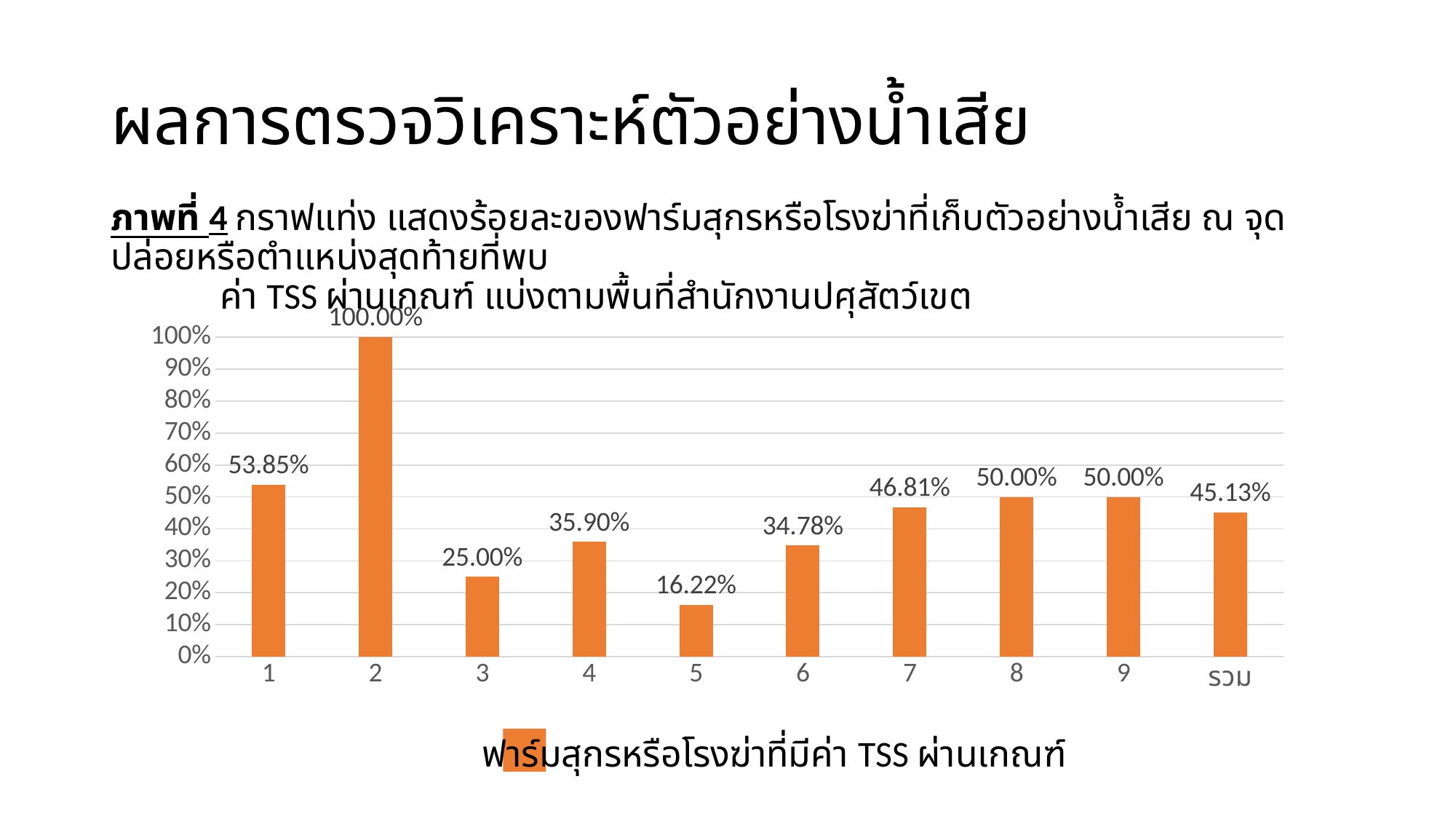
What is the value for category 5? 16.22% Is the value for category 7 greater or less than 40%? greater Which category has the lowest value? 5 What is the difference between the values for category 2 and category 3? 75.00% What kind of chart is shown on the slide? bar chart What is the value for the รวม category? 45.13% Which category has the highest value? 2 What is the legend entry for the series? ฟาร์มสุกรหรือโรงฆ่าที่มีค่า TSS ผ่านเกณฑ์ Which is larger, the value for category 4 or the value for category 6? 4 How many categories are shown on the x axis? 10 What is the value for category 1? 53.85% How many series does the legend list? 1